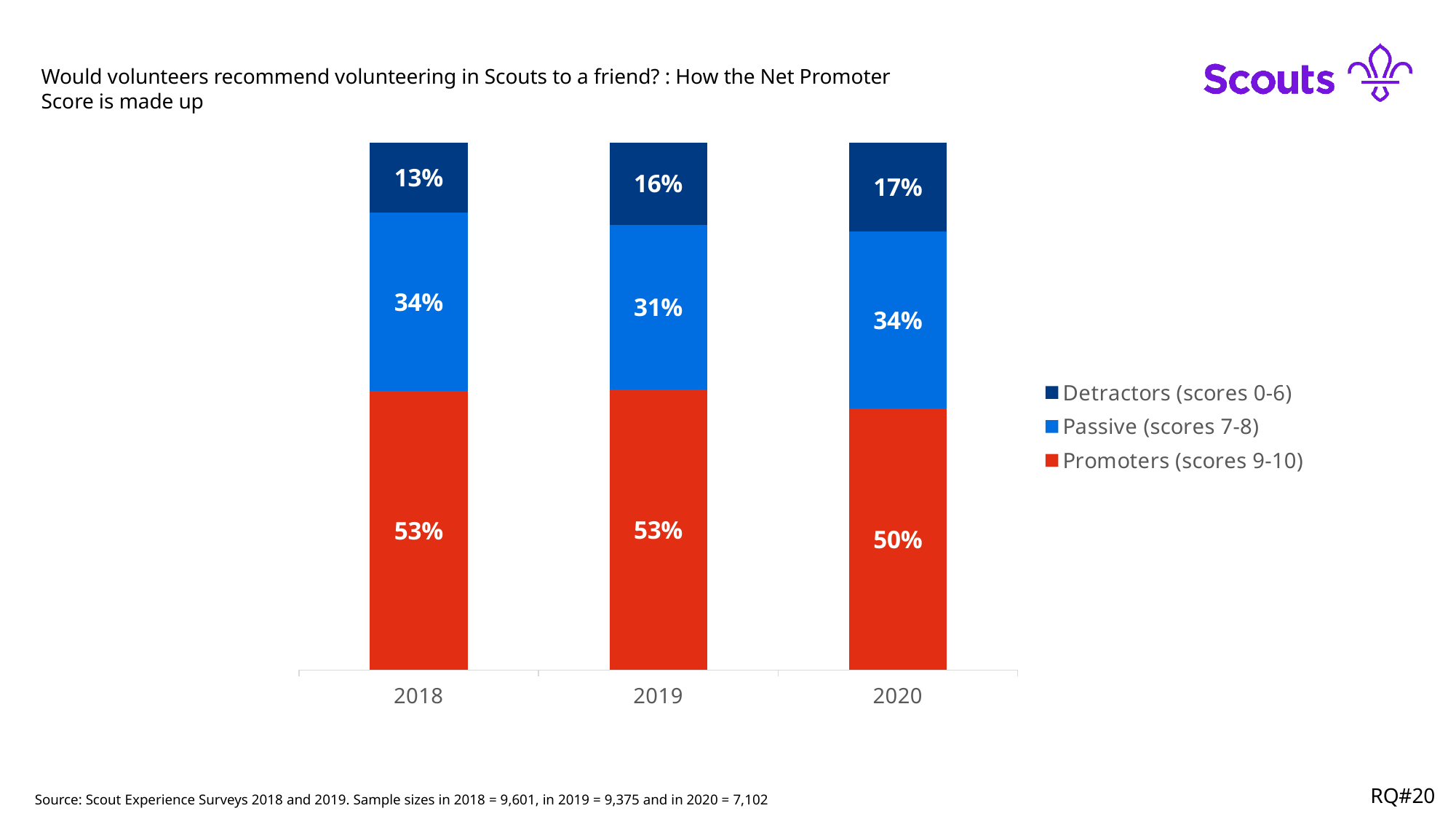
Which is larger: the Promoters (scores 9-10) share in 2019 or in 2020? 2019 What percentage of volunteers were Detractors (scores 0-6) in 2018? 13% By how many percentage points did the Detractors (scores 0-6) share change from 2018 to 2020? 4 percentage points Which colour represents Promoters (scores 9-10) in the chart? Red Does the Detractors (scores 0-6) share rise or fall from 2018 to 2020? Rise What percentage of volunteers were Passive (scores 7-8) in 2019? 31% What kind of chart is shown on the slide? Stacked bar chart What percentage of volunteers were Promoters (scores 9-10) in 2020? 50% How many years are shown on the x axis? 3 In which year was the Detractors (scores 0-6) share highest? 2020 In which year was the Passive (scores 7-8) share lowest? 2019 How many series does the legend list? 3